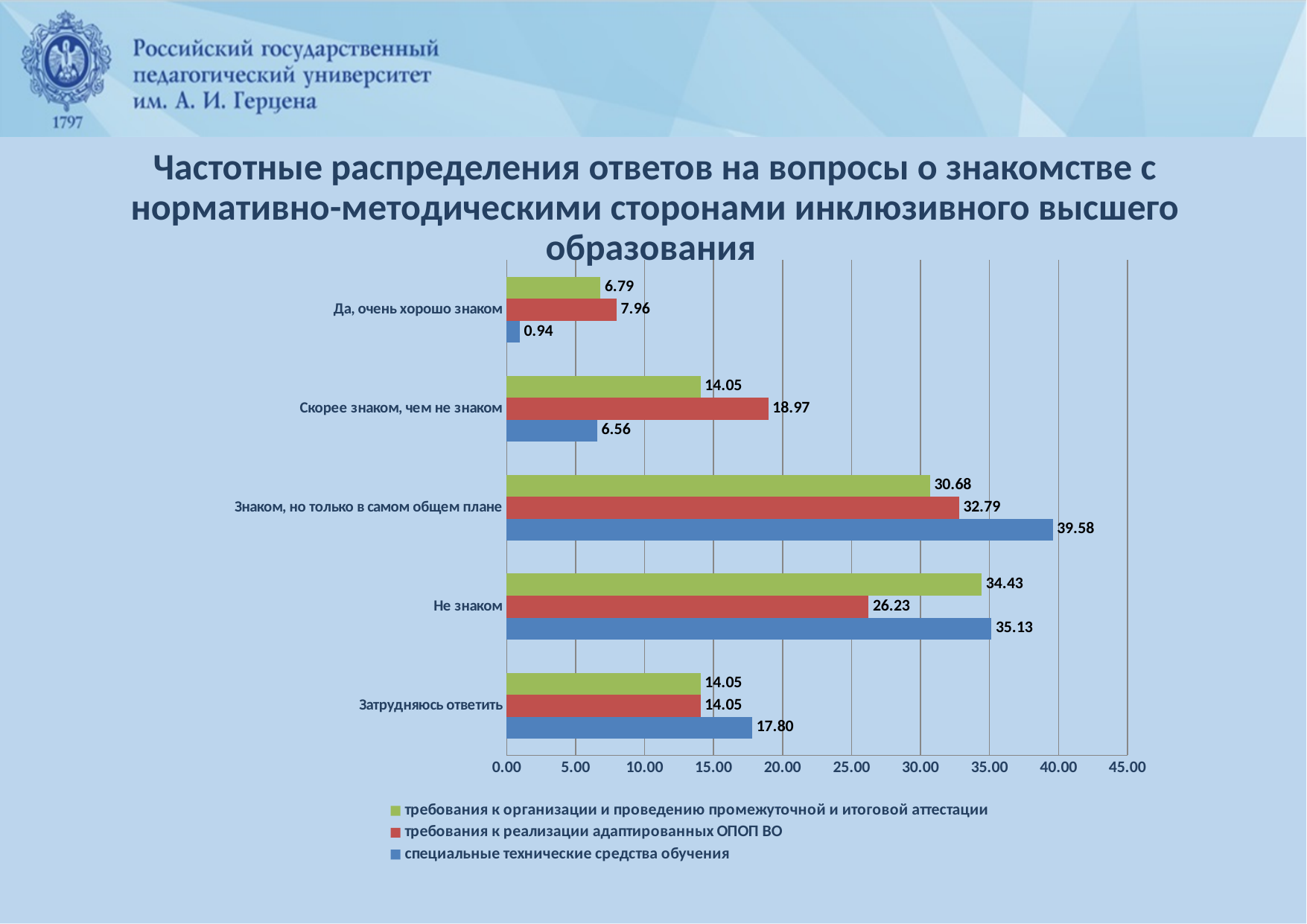
What is the value for «специальные технические средства обучения» in the category «Знаком, но только в самом общем плане»? 39.58 In the category «Затрудняюсь ответить», which series has the larger value: «специальные технические средства обучения» or «требования к реализации адаптированных ОПОП ВО»? специальные технические средства обучения How many series does the legend list? 3 How many response categories are shown on the chart? 5 Which category has the lowest value for «специальные технические средства обучения»? Да, очень хорошо знаком Which category has the highest value for «требования к организации и проведению промежуточной и итоговой аттестации»? Не знаком What is the value for «требования к реализации адаптированных ОПОП ВО» in the category «Скорее знаком, чем не знаком»? 18.97 What is the difference between the «специальные технические средства обучения» and «требования к реализации адаптированных ОПОП ВО» values in the category «Не знаком»? 8.90 What colour represents the series «требования к реализации адаптированных ОПОП ВО» in the legend? red What type of chart is shown on the slide? bar chart Is the value for «требования к реализации адаптированных ОПОП ВО» in the category «Знаком, но только в самом общем плане» greater or less than 30.00? greater What is the value for «требования к организации и проведению промежуточной и итоговой аттестации» in the category «Не знаком»? 34.43